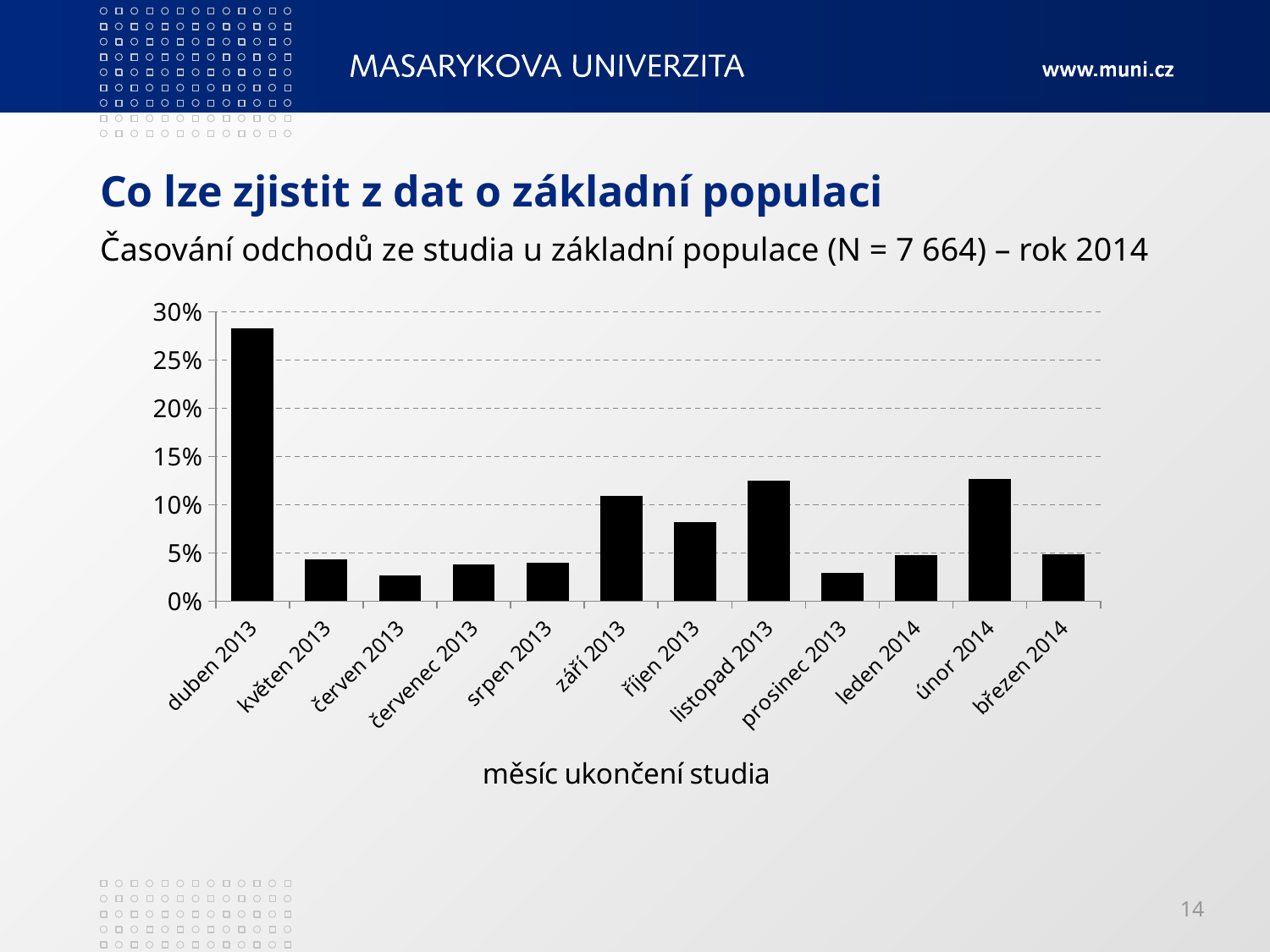
Is the value for říjen 2013 greater or less than 10%? less Which month has the highest value in the chart? duben 2013 What is the title of the x axis of the chart? měsíc ukončení studia What colour are the bars in the chart? black How many months (categories) are shown on the x axis of the chart? 12 Is the value for únor 2014 greater or less than 10%? greater Which is larger, the value for září 2013 or the value for říjen 2013? září 2013 Which is larger, the value for duben 2013 or the value for listopad 2013? duben 2013 Is the value for květen 2013 greater or less than 5%? less What kind of chart is shown on the slide? bar chart